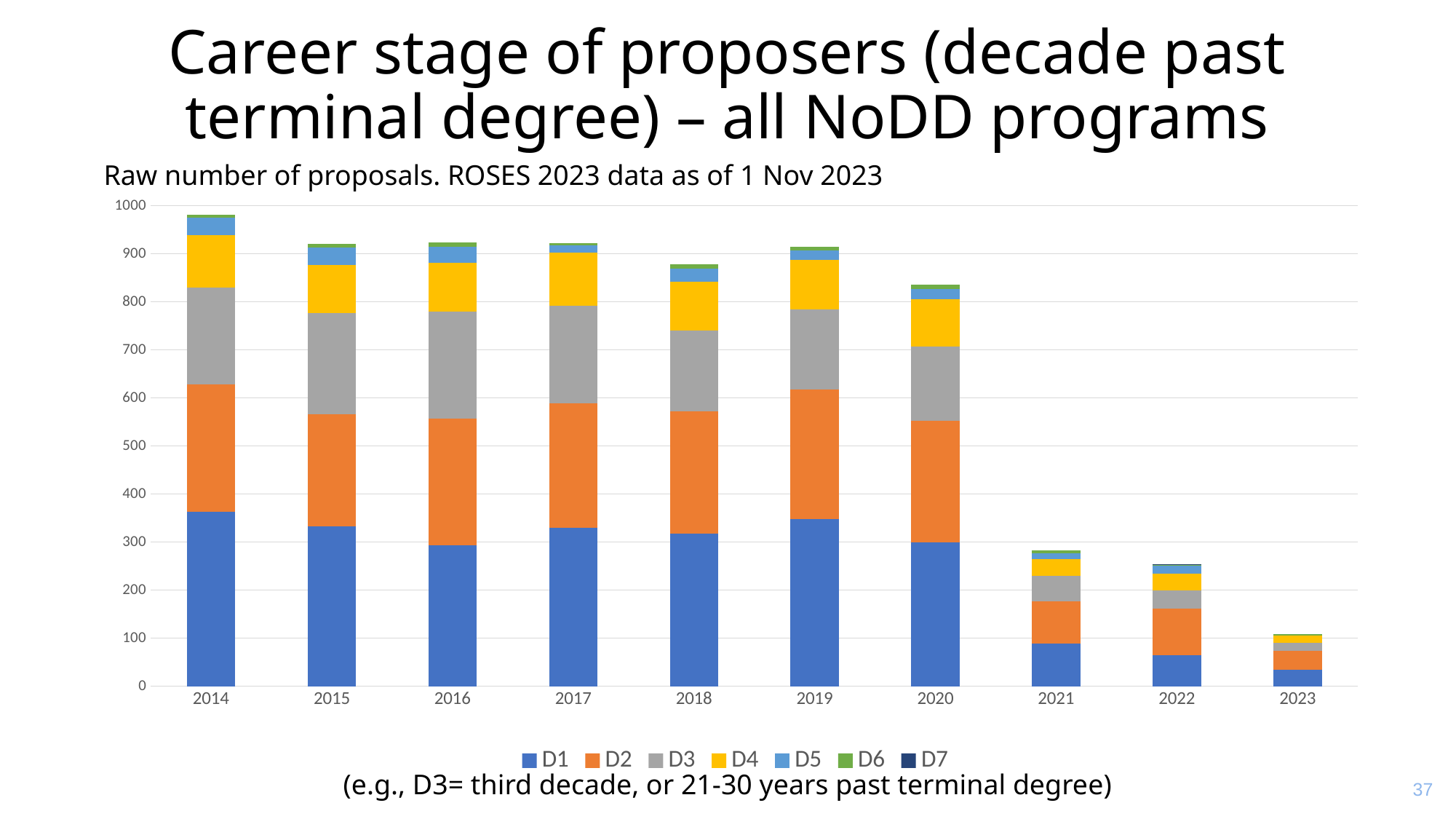
Which year has the shortest stacked bar (lowest total number of proposals)? 2023 Which year has the larger total bar, 2019 or 2020? 2019 Which year has the tallest stacked bar (highest total number of proposals)? 2014 How many series does the legend list? 7 Is the D1 value for 2014 greater or less than 300? greater Which colour represents the D1 series in the legend? Blue Is the total bar height for 2014 greater or less than 900? greater Is the total bar height for 2020 greater or less than 800? greater Do the total bar heights generally rise or fall from 2014 to 2023? fall What kind of chart is shown on the slide? Stacked bar chart How many years (categories) are shown on the x axis? 10